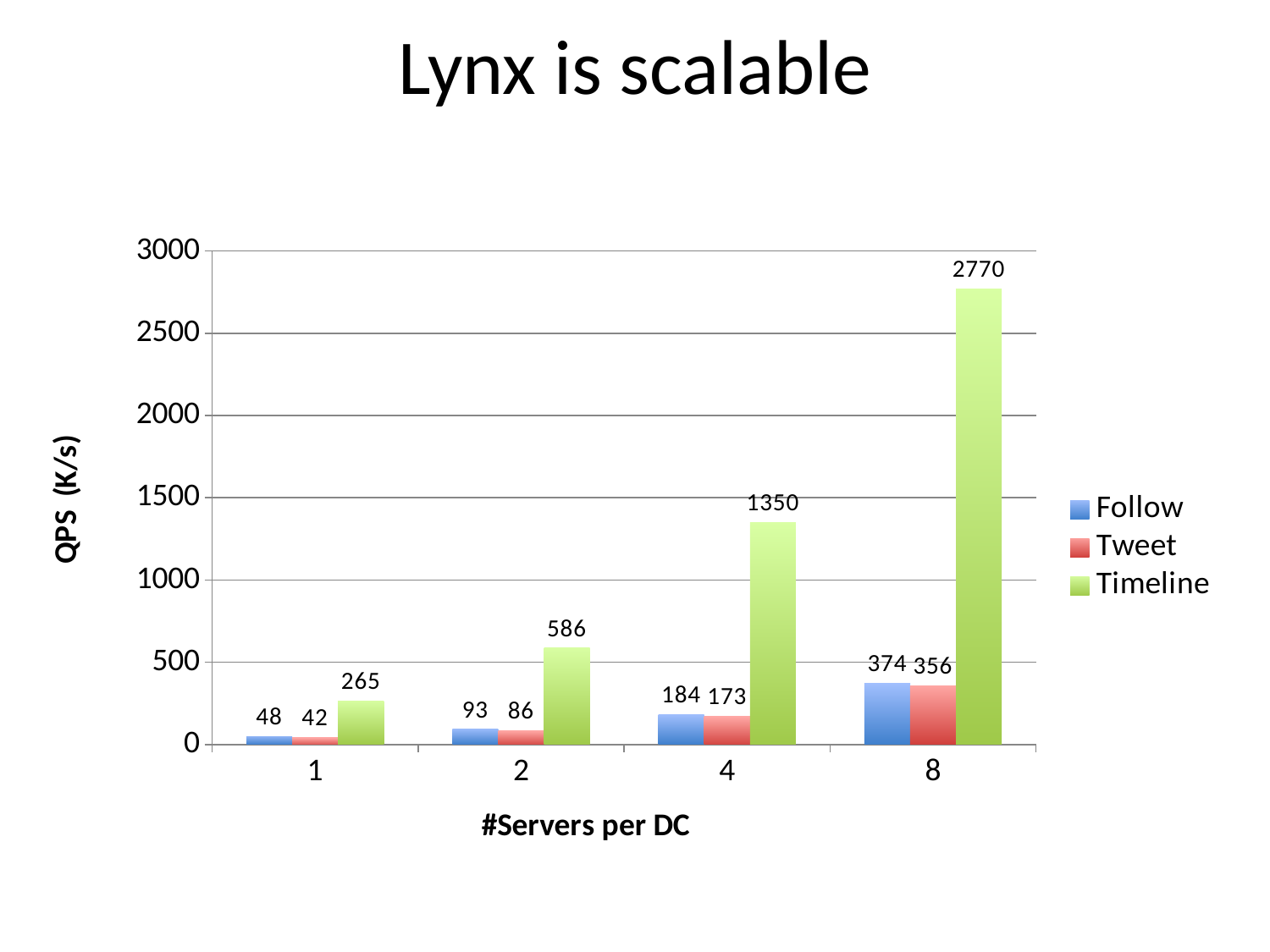
Which is larger at 2 servers per DC, Follow or Tweet? Follow How many categories are shown on the x axis? 4 Which number of servers per DC has the highest Timeline value? 8 What is the difference between the Timeline values for 8 and 4 servers per DC? 1420 What is the Timeline QPS value for 8 servers per DC? 2770 Which series has the lowest value at 1 server per DC? Tweet What is the Tweet QPS value for 4 servers per DC? 173 What is the difference between the Follow and Tweet values at 8 servers per DC? 18 What kind of chart is shown on the slide? Bar chart Is the Timeline value for 4 servers per DC greater or less than 1000? greater How many series does the legend list? 3 What is the Follow QPS value for 2 servers per DC? 93